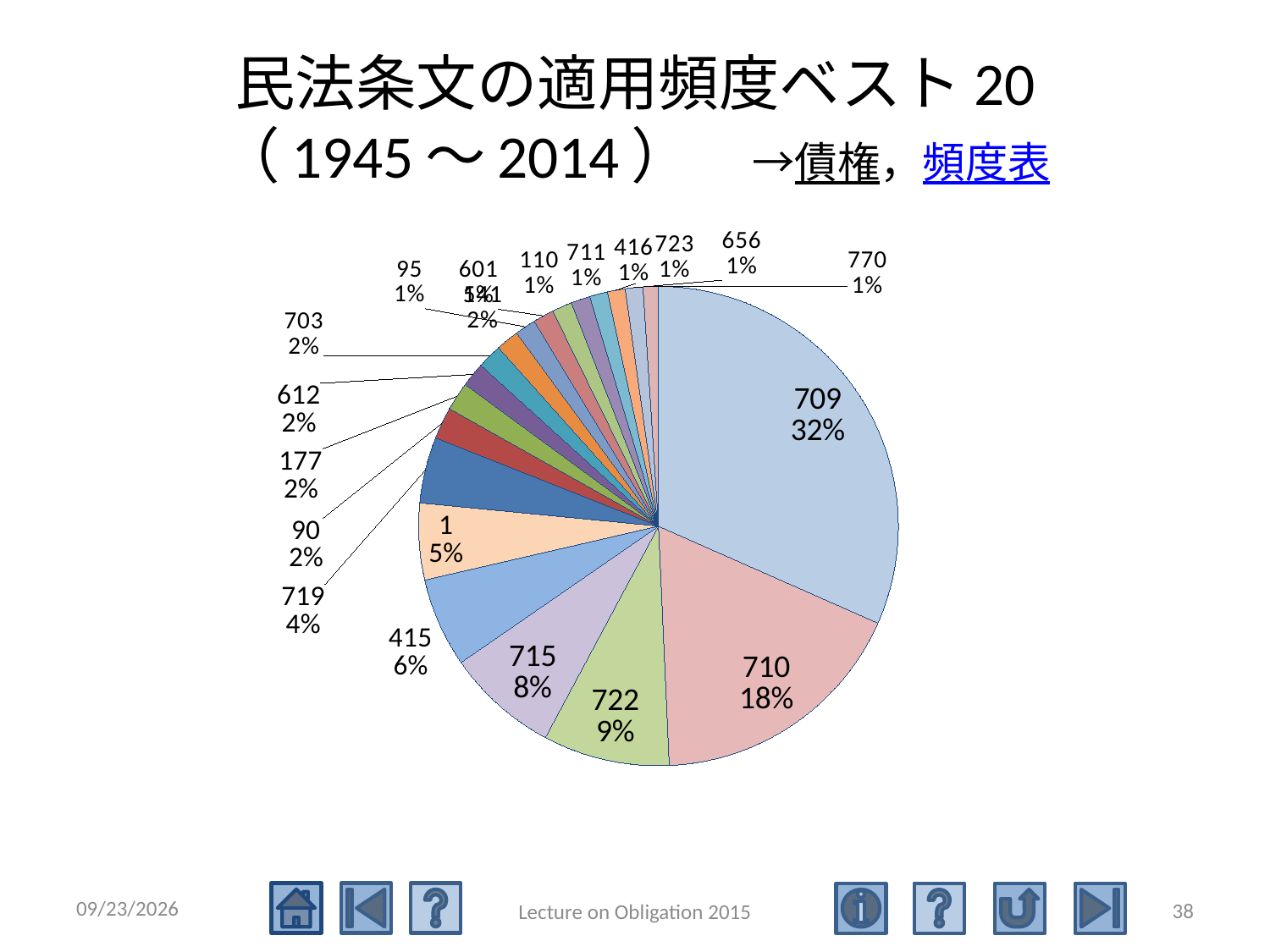
Which has the larger share, article 722 or article 415? 722 What is the difference in percentage points between article 709 and article 710? 14 What percentage is shown for article 719? 4% What percentage is shown for article 415? 6% What year range is given in the chart's title? 1945～2014 Which article has the largest slice of the pie? 709 What share of the pie does article 709 account for? 32% What share of the pie does article 710 account for? 18% What percentage is shown for article 722? 9% What percentage is shown for article 715? 8% How many slices does the pie chart have? 20 What kind of chart is shown on the slide? pie chart